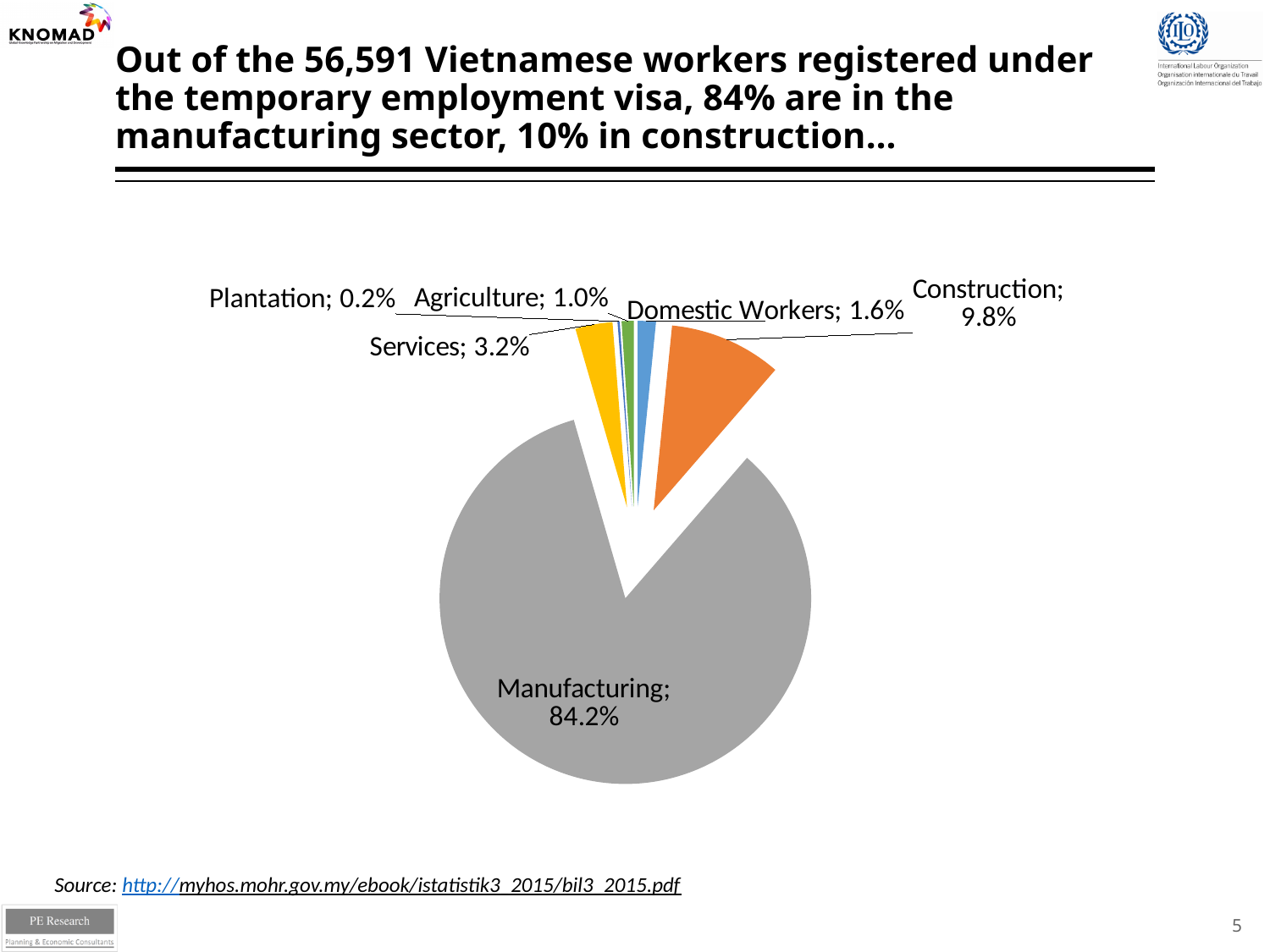
What is the difference between the Construction and Services shares? 6.6% How many sectors are shown in the pie chart? 6 Which is larger, the share for Domestic Workers or the share for Agriculture? Domestic Workers What is the value shown for Construction? 9.8% What is the value shown for Services? 3.2% What colour is the Manufacturing slice? grey Which sector has the largest slice of the pie? Manufacturing Which sector has the smallest slice of the pie? Plantation What is the value shown for Agriculture? 1.0% What kind of chart is shown on the slide? pie chart What is the value shown for Domestic Workers? 1.6% What share of the pie does Manufacturing account for? 84.2%